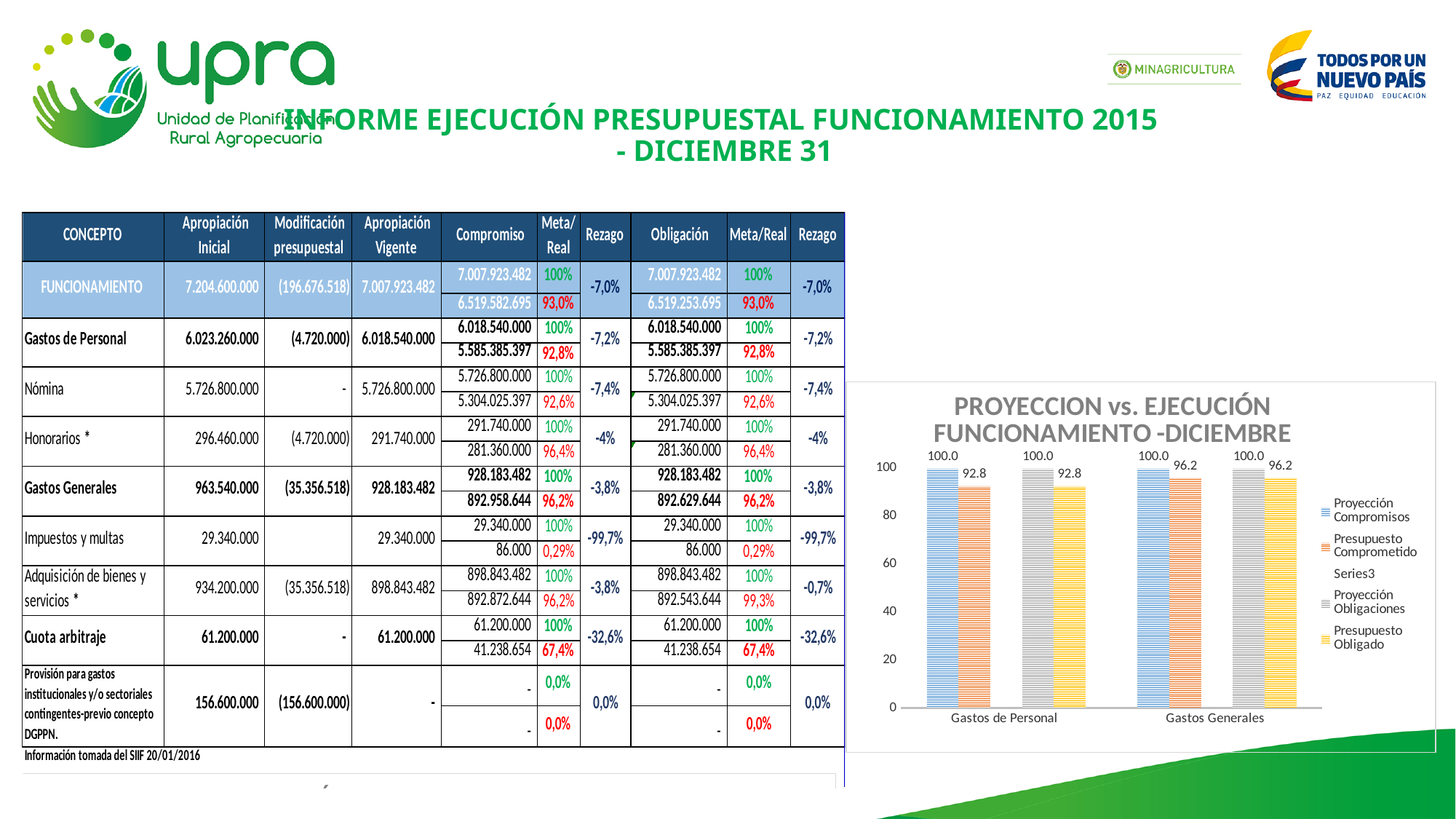
In the chart, what is the value of Presupuesto Obligado for Gastos Generales? 96.2 In the chart, what is the difference between Proyección Compromisos and Presupuesto Comprometido for Gastos de Personal? 7.2 How many categories are shown on the x axis of the chart? 2 How many series does the chart legend list? 5 In the chart, which legend entry has no visible bars plotted? Series3 In the chart, what is the difference between Proyección Obligaciones and Presupuesto Obligado for Gastos Generales? 3.8 In the chart, what is the value of Presupuesto Comprometido for Gastos de Personal? 92.8 In the chart, what is the value of Proyección Compromisos for Gastos Generales? 100.0 What type of chart is shown on the right side of the slide? bar chart What is the title of the chart on the slide? PROYECCION vs. EJECUCIÓN FUNCIONAMIENTO -DICIEMBRE In the chart, which category has the higher Presupuesto Comprometido value, Gastos de Personal or Gastos Generales? Gastos Generales In the chart, is the Presupuesto Obligado value for Gastos de Personal greater or less than 80? greater